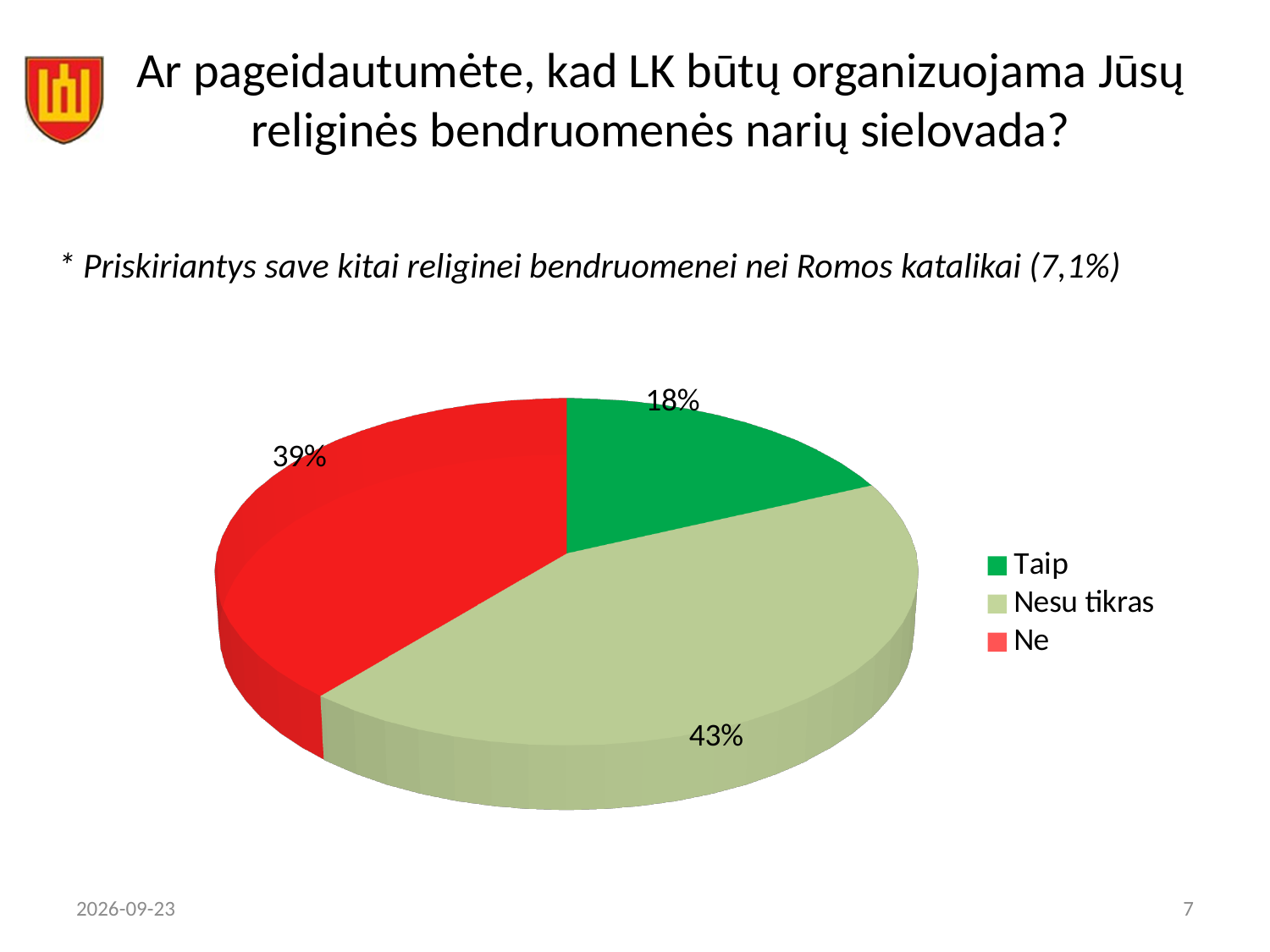
What percentage of respondents answered "Ne"? 39% What percentage of respondents answered "Nesu tikras"? 43% Which response has the largest share of the pie? Nesu tikras What is the difference in percentage points between "Ne" and "Taip"? 21 How many slices does the pie chart have? 3 What colour is the "Ne" slice in the pie chart? red What percentage of respondents answered "Taip"? 18% What is the difference in percentage points between "Nesu tikras" and "Ne"? 4 What kind of chart is shown on the slide? pie chart Which is larger, the share for "Ne" or the share for "Taip"? Ne Which response has the smallest share of the pie? Taip How many entries does the legend list? 3